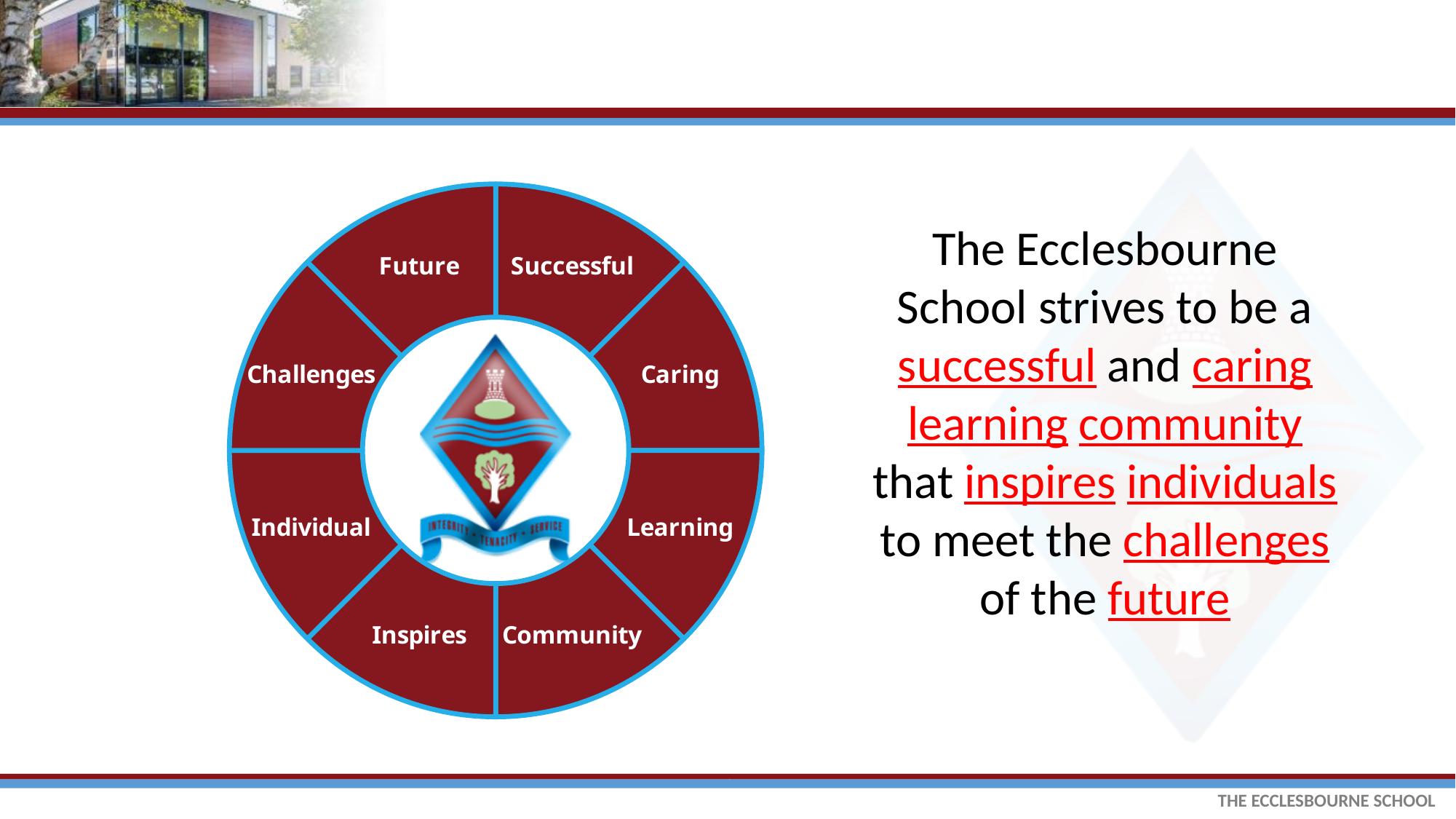
Which segment of the ring is labelled at the bottom right, next to 'Community'? Learning What kind of chart is the diagram on the left of the slide? Doughnut chart What colour are the segments of the ring diagram? Dark red Which segment label sits directly to the right of the 'Future' segment at the top of the ring? Successful How many segments does the ring diagram on the left of the slide have? 8 Which segment label appears at the far left of the ring, above 'Individual'? Challenges